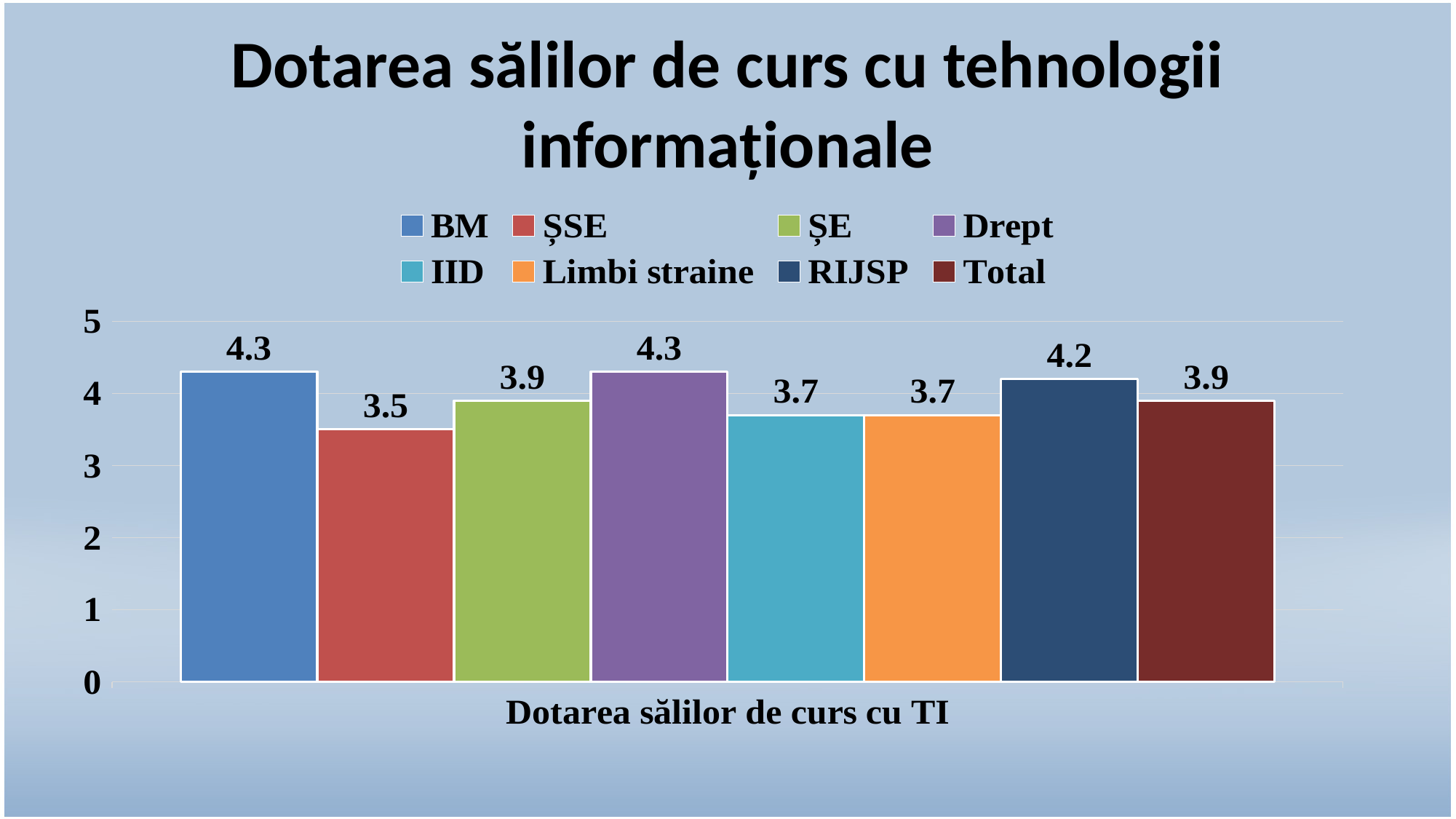
Which is larger, the value for ȘE or the value for Limbi straine? ȘE What is the value for BM? 4.3 What is the value for RIJSP? 4.2 What kind of chart is shown on the slide? Bar chart What is the difference between the values for BM and ȘSE? 0.8 What is the title of the chart? Dotarea sălilor de curs cu tehnologii informaționale How many series does the legend list? 8 Which series has the lowest value? ȘSE What is the difference between the values for RIJSP and IID? 0.5 What is the value for Total? 3.9 What is the value for ȘSE? 3.5 Is the value for Drept greater or less than 4? greater